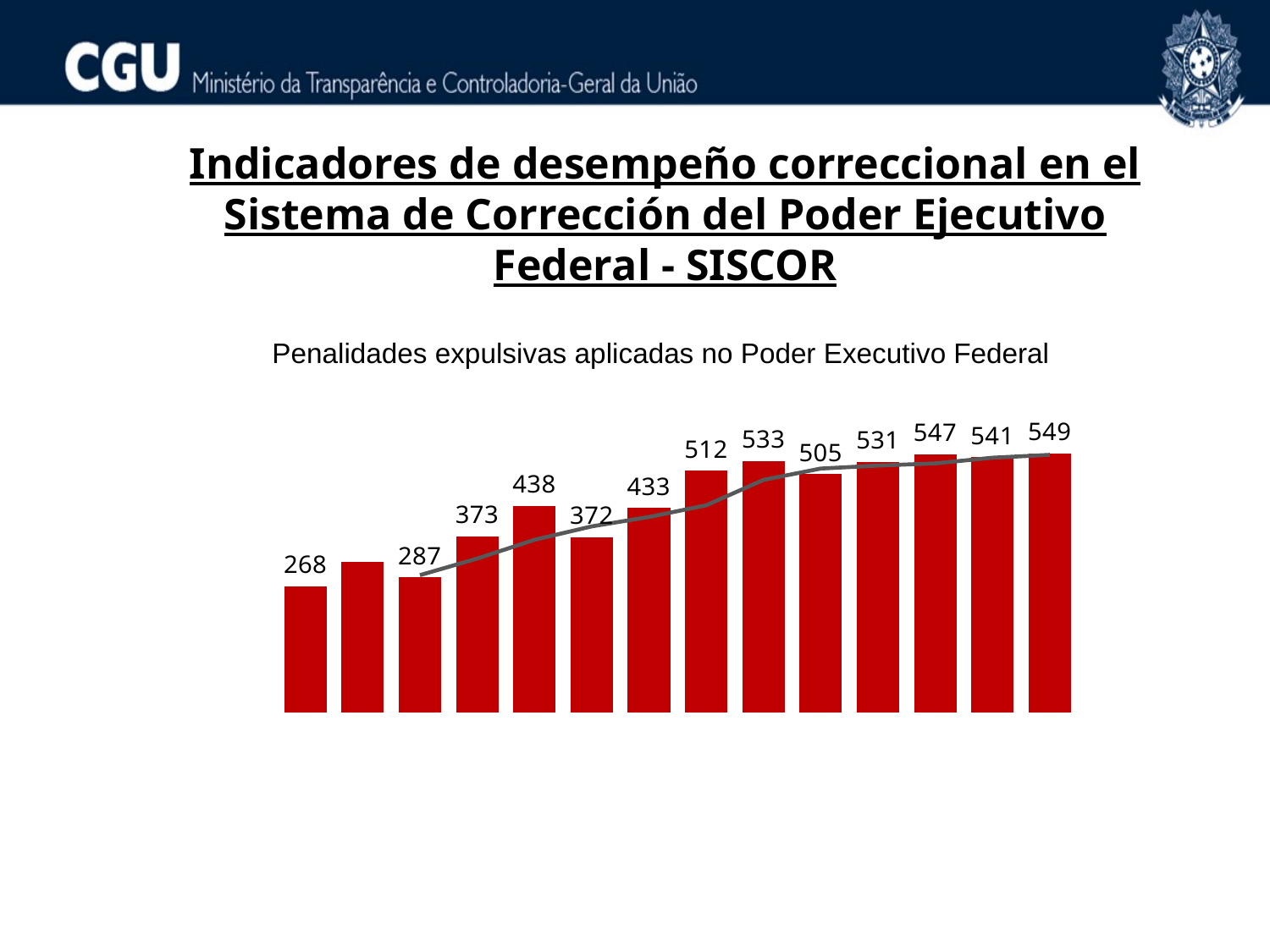
What is the value labelled on the last (rightmost) bar of the chart? 549 What is the value labelled on the fifth bar from the left? 438 What is the value labelled on the first (leftmost) bar of the chart? 268 What is the difference between the last bar (549) and the first bar (268)? 281 What is the difference between the bars labelled 438 and 372? 66 What kind of chart is shown on the slide? bar chart Which is larger, the bar labelled 533 or the bar labelled 505? 533 What is the highest value labelled on the chart? 549 Do the bar values generally rise or fall from left to right across the chart? rise What is the title shown above the chart? Penalidades expulsivas aplicadas no Poder Executivo Federal What is the lowest value labelled on the chart? 268 How many bars does the chart contain? 14